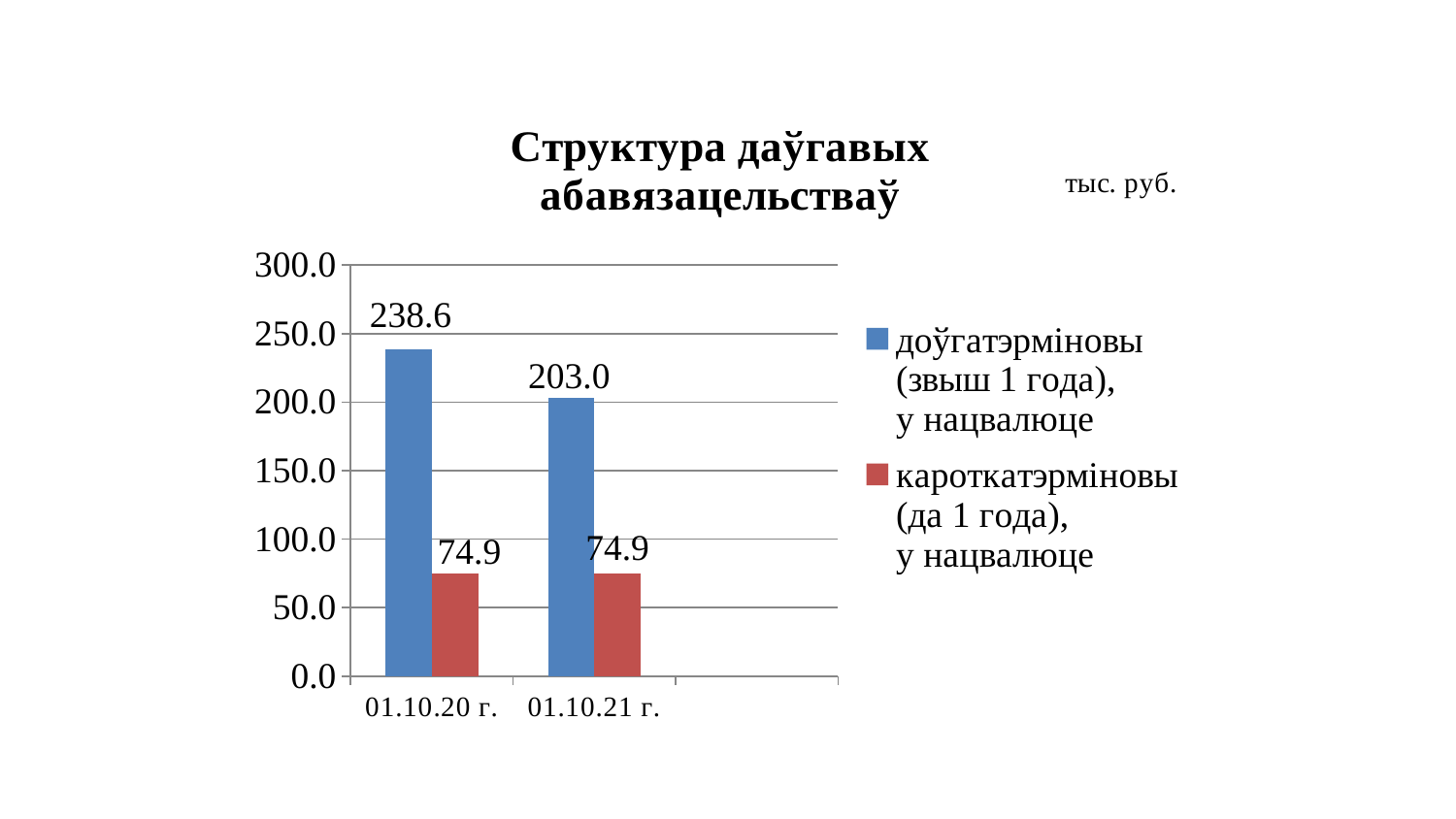
What is the difference between the long-term and short-term values on 01.10.21 г.? 128.1 How many dates are shown on the x axis? 2 Which date has the higher value for the long-term (доўгатэрміновы) series? 01.10.20 г. What is the value of the long-term (доўгатэрміновы) series for 01.10.21 г.? 203.0 What is the value of the short-term (кароткатэрміновы) series for 01.10.21 г.? 74.9 By how much did the long-term (доўгатэрміновы) value change from 01.10.20 г. to 01.10.21 г.? 35.6 What is the value of the long-term (доўгатэрміновы) series for 01.10.20 г.? 238.6 What kind of chart is shown on the slide? bar chart What is the total of the long-term and short-term values for 01.10.20 г.? 313.5 How many series does the legend list? 2 Which is larger on 01.10.20 г.: the long-term or the short-term value? long-term (доўгатэрміновы) Is the long-term value for 01.10.21 г. greater or less than 250.0? less